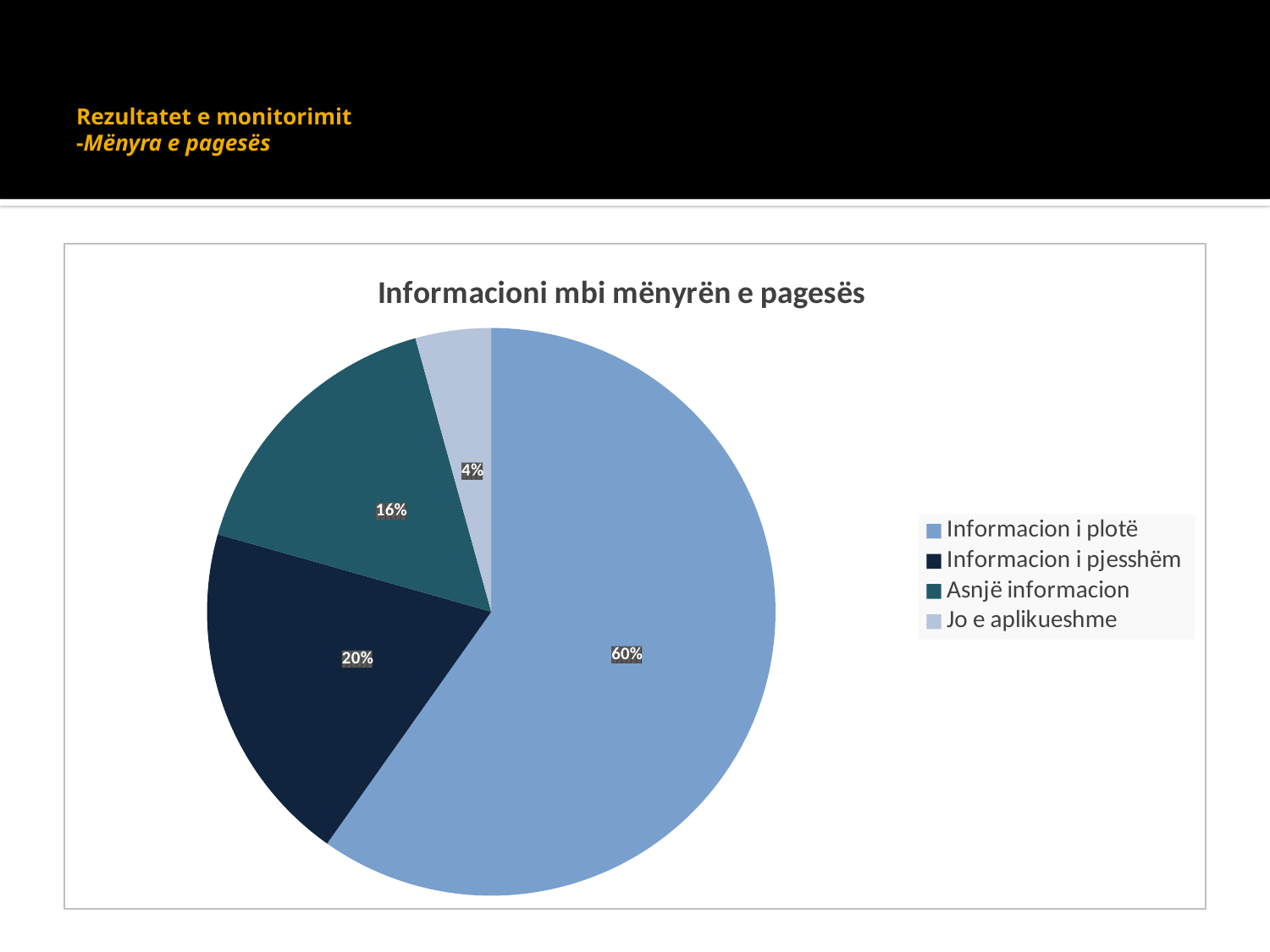
Which category has the largest slice of the pie? Informacion i plotë What type of chart is shown on the slide? pie chart How many categories does the pie chart have? 4 What is the difference in percentage points between 'Informacion i plotë' and 'Informacion i pjesshëm'? 40 What is the title of the chart? Informacioni mbi mënyrën e pagesës What share of the pie is 'Informacion i plotë'? 60% How many entries does the legend list? 4 Which category has the smallest slice of the pie? Jo e aplikueshme What share of the pie is 'Informacion i pjesshëm'? 20% Which is larger: the slice for 'Asnjë informacion' or the slice for 'Informacion i pjesshëm'? Informacion i pjesshëm What share of the pie is 'Jo e aplikueshme'? 4%